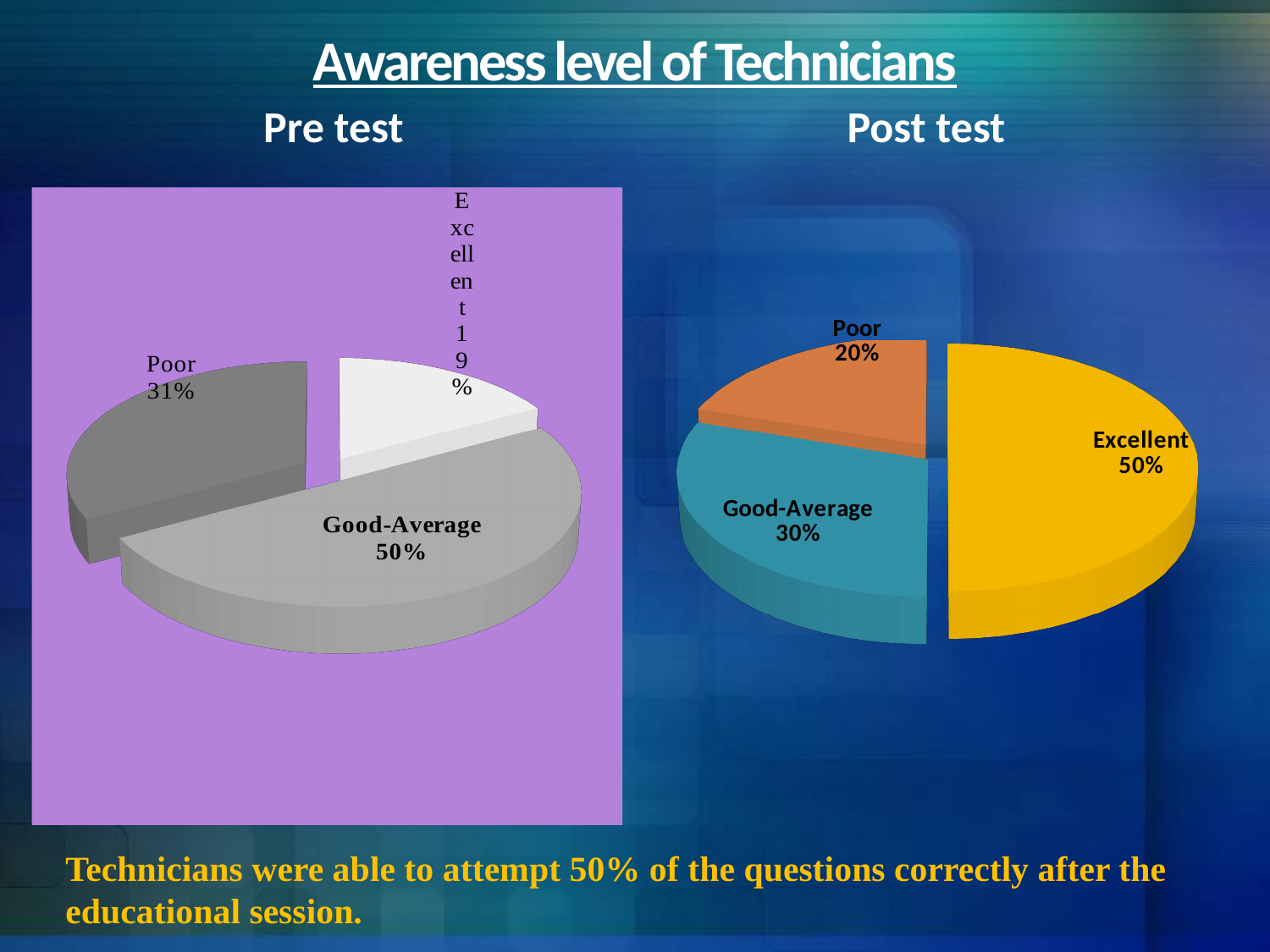
What type of chart is the Post test chart? Pie chart Which is larger: the Poor share in the Pre test chart or the Poor share in the Post test chart? Pre test In the Post test chart, what percentage is labelled Excellent? 50% How many categories does the Post test chart show? 3 In the Pre test chart, which category has the largest slice? Good-Average In the Post test chart, which category has the largest slice? Excellent In the Pre test chart, what percentage is labelled Poor? 31% In the Pre test chart, what percentage is labelled Good-Average? 50% In the Post test chart, what percentage is labelled Poor? 20% In the Post test chart, what percentage is labelled Good-Average? 30% In the Post test chart, which category has the smallest slice? Poor In the Post test chart, what is the difference between the Excellent and Poor percentages? 30%